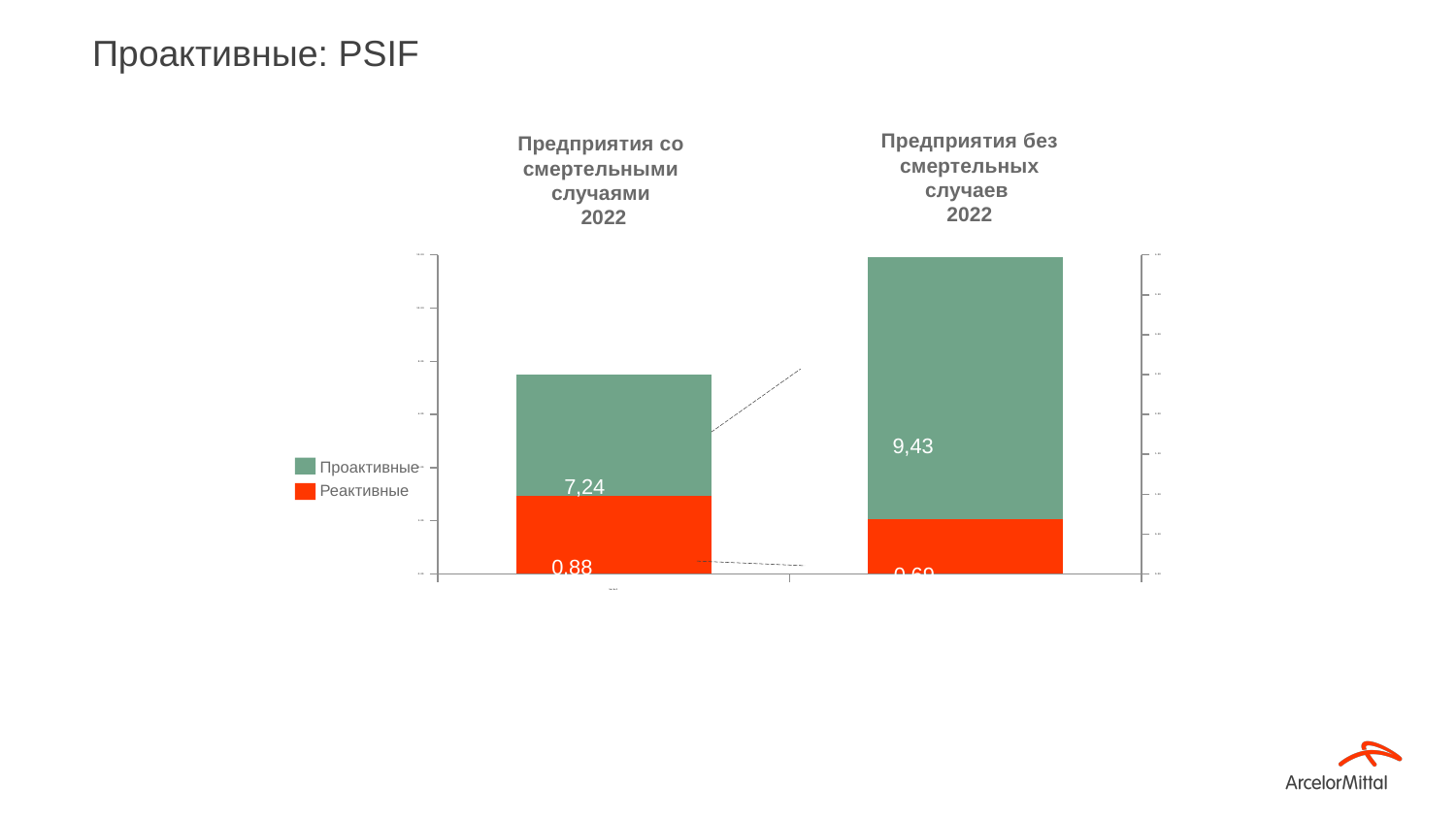
What is the total of the stacked bar for Предприятия со смертельными случаями 2022? 8,12 What is the difference between the Проактивные values of Предприятия без смертельных случаев 2022 and Предприятия со смертельными случаями 2022? 2,19 Is the Проактивные value for Предприятия со смертельными случаями 2022 larger or smaller than the Проактивные value for Предприятия без смертельных случаев 2022? Smaller Which category has the lower Проактивные value? Предприятия со смертельными случаями 2022 Which category has the higher Проактивные value? Предприятия без смертельных случаев 2022 How many series does the legend list? 2 What is the Проактивные value for Предприятия со смертельными случаями 2022? 7,24 How many categories are shown on the chart? 2 What type of chart is shown on the slide? Stacked bar chart What is the Реактивные value for Предприятия со смертельными случаями 2022? 0,88 What is the Проактивные value for Предприятия без смертельных случаев 2022? 9,43 Which colour represents the Реактивные series in the legend? Red